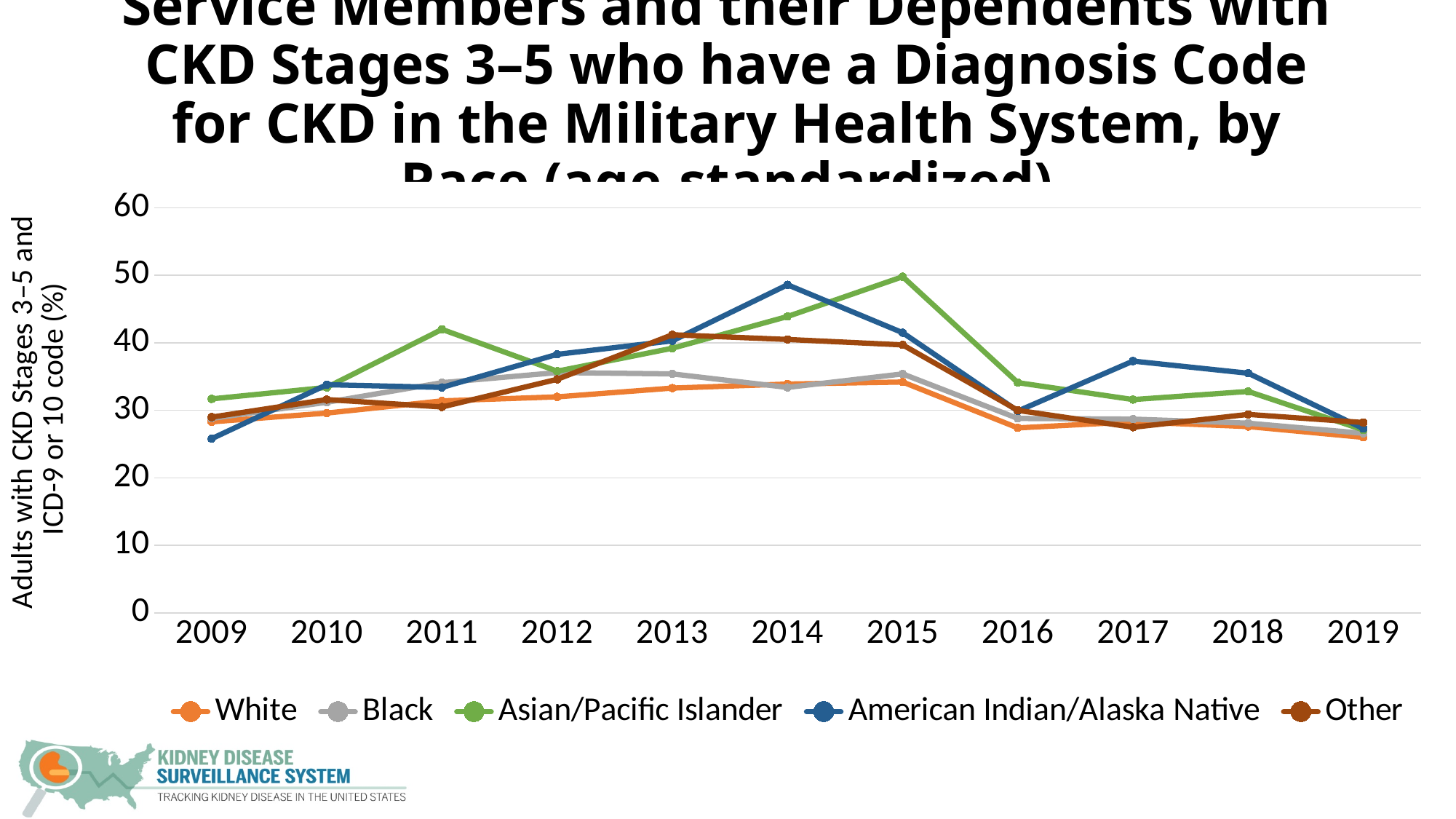
In 2011, which is larger: the value for Asian/Pacific Islander or the value for White? Asian/Pacific Islander Is the value for White in 2016 greater or less than 30? less Which series has the highest value in 2017? American Indian/Alaska Native Which series has the lowest value in 2009? American Indian/Alaska Native Is the value for American Indian/Alaska Native in 2009 greater or less than 30? less What kind of chart is shown on the slide? line chart Is the value for Asian/Pacific Islander in 2015 greater or less than 40? greater How many series does the legend list? 5 Does the White series rise or fall from 2015 to 2016? fall How many years are plotted along the x axis? 11 Which series has the highest value in 2015? Asian/Pacific Islander